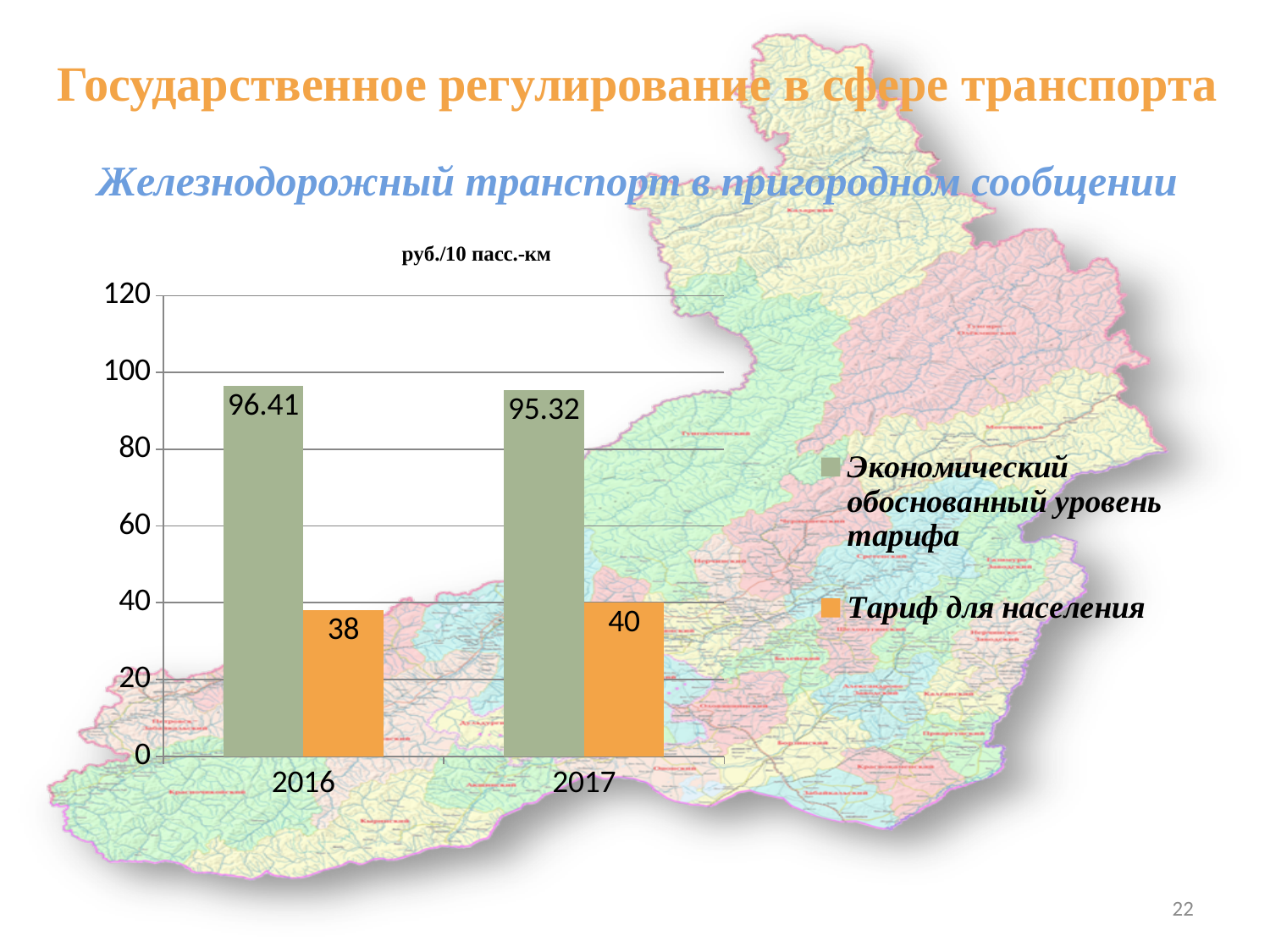
Which is larger in 2016: 'Экономический обоснованный уровень тарифа' or 'Тариф для населения'? Экономический обоснованный уровень тарифа What is the value of 'Экономический обоснованный уровень тарифа' for 2016? 96.41 In which year is 'Тариф для населения' lower? 2016 How many series does the legend list? 2 What kind of chart is shown on the slide? Bar chart What is the value of 'Тариф для населения' for 2017? 40 In which year is 'Экономический обоснованный уровень тарифа' higher? 2016 What is the difference between 'Экономический обоснованный уровень тарифа' and 'Тариф для населения' in 2017? 55.32 What is the difference between 'Экономический обоснованный уровень тарифа' in 2016 and in 2017? 1.09 What is the value of 'Тариф для населения' for 2016? 38 What is the value of 'Экономический обоснованный уровень тарифа' for 2017? 95.32 What unit is shown above the chart? руб./10 пасс.-км